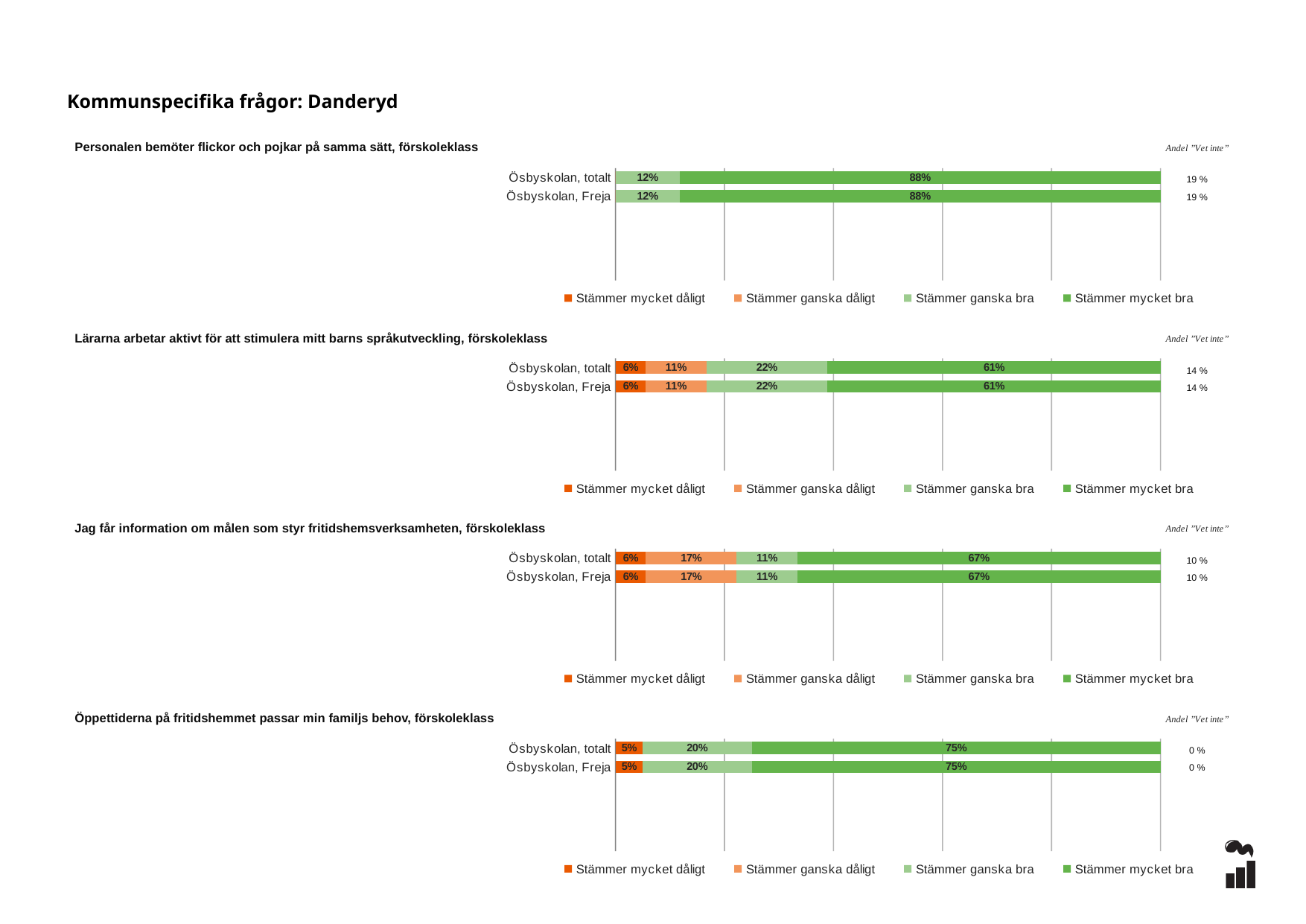
In the chart 'Personalen bemöter flickor och pojkar på samma sätt, förskoleklass', what is the value of 'Stämmer mycket bra' for Ösbyskolan, totalt? 88% How many series does the legend list in the chart 'Öppettiderna på fritidshemmet passar min familjs behov, förskoleklass'? 4 In the chart 'Jag får information om målen som styr fritidshemsverksamheten, förskoleklass', which response category has the lowest value for Ösbyskolan, totalt? Stämmer mycket dåligt In the chart 'Lärarna arbetar aktivt för att stimulera mitt barns språkutveckling, förskoleklass', which response category has the highest value for Ösbyskolan, Freja? Stämmer mycket bra In the chart 'Jag får information om målen som styr fritidshemsverksamheten, förskoleklass', what is the value of 'Stämmer ganska dåligt' for Ösbyskolan, Freja? 17% In the chart 'Personalen bemöter flickor och pojkar på samma sätt, förskoleklass', what is the value of 'Stämmer ganska bra' for Ösbyskolan, Freja? 12% In the chart 'Öppettiderna på fritidshemmet passar min familjs behov, förskoleklass', what is the value of 'Stämmer mycket bra' for Ösbyskolan, totalt? 75% In the chart 'Lärarna arbetar aktivt för att stimulera mitt barns språkutveckling, förskoleklass', what is the value of 'Stämmer ganska dåligt' for Ösbyskolan, totalt? 11% In the chart 'Jag får information om målen som styr fritidshemsverksamheten, förskoleklass', which is larger for Ösbyskolan, totalt: 'Stämmer ganska dåligt' or 'Stämmer ganska bra'? Stämmer ganska dåligt In the chart 'Öppettiderna på fritidshemmet passar min familjs behov, förskoleklass', what is the 'Andel Vet inte' value for Ösbyskolan, Freja? 0 % In the chart 'Lärarna arbetar aktivt för att stimulera mitt barns språkutveckling, förskoleklass', what is the difference between 'Stämmer mycket bra' and 'Stämmer ganska bra' for Ösbyskolan, totalt? 39% What kind of chart is 'Personalen bemöter flickor och pojkar på samma sätt, förskoleklass'? Stacked bar chart